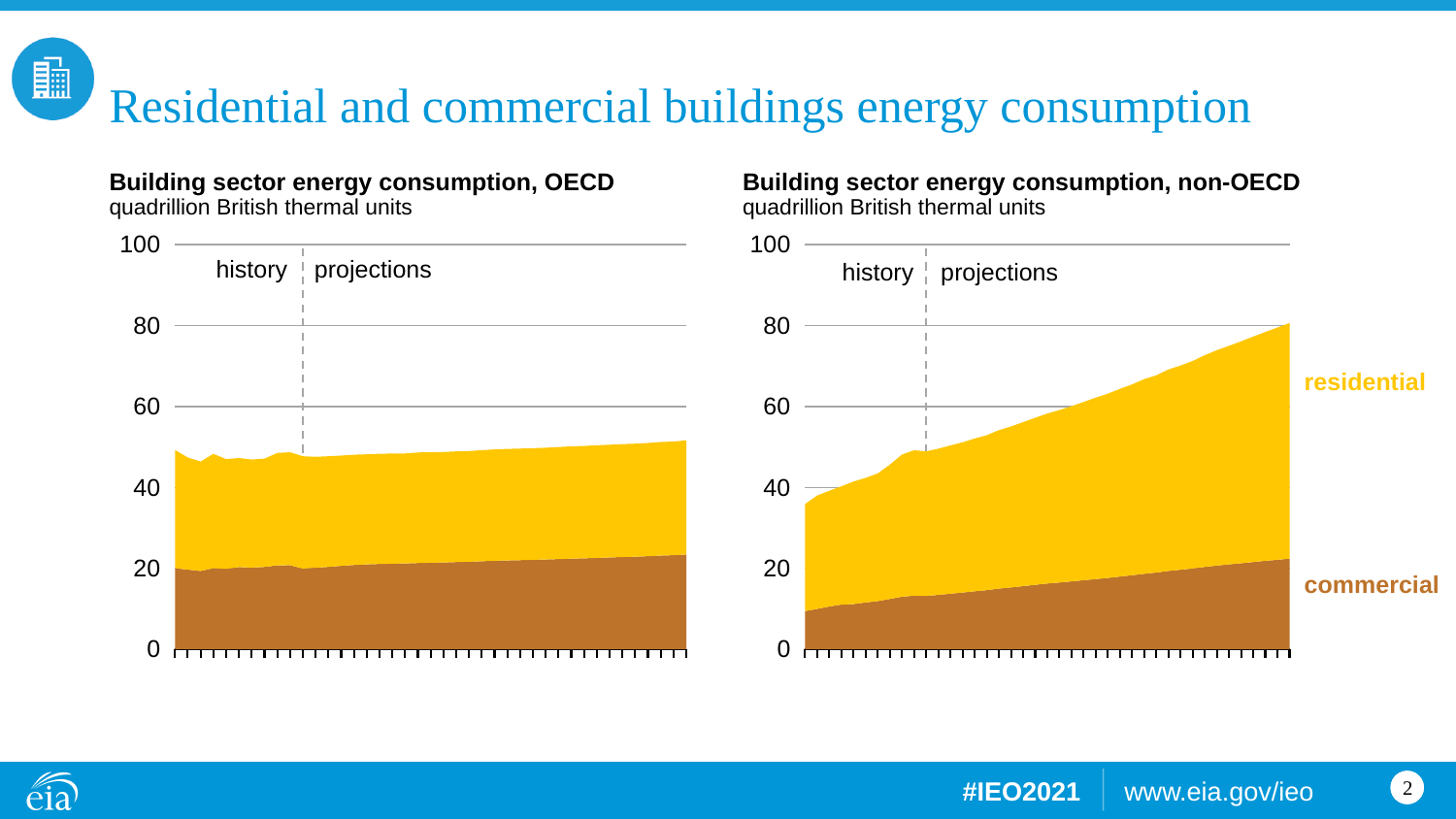
In the 'Building sector energy consumption, non-OECD' chart, is commercial consumption at the end of the projection period greater or less than 20? greater What kind of chart is the 'Building sector energy consumption, OECD' chart? stacked area chart In the 'Building sector energy consumption, non-OECD' chart, does total building energy consumption rise or fall over the projection period? rise In the 'Building sector energy consumption, non-OECD' chart, which series is larger at the end of the projection period, residential or commercial? residential How many series are shown in the 'Building sector energy consumption, non-OECD' chart? 2 In the 'Building sector energy consumption, OECD' chart, is the total consumption at the end of the projection period greater or less than 40? greater What are the two series labelled in the 'Building sector energy consumption, non-OECD' chart? residential and commercial In the 'Building sector energy consumption, OECD' chart, is the total consumption at the end of the projection period greater or less than 60? less In the 'Building sector energy consumption, OECD' chart, does commercial consumption rise or fall over the projection period? rise What unit is used on the y axis of both charts? quadrillion British thermal units At the end of the projection period, which region has higher total building sector energy consumption, OECD or non-OECD? non-OECD